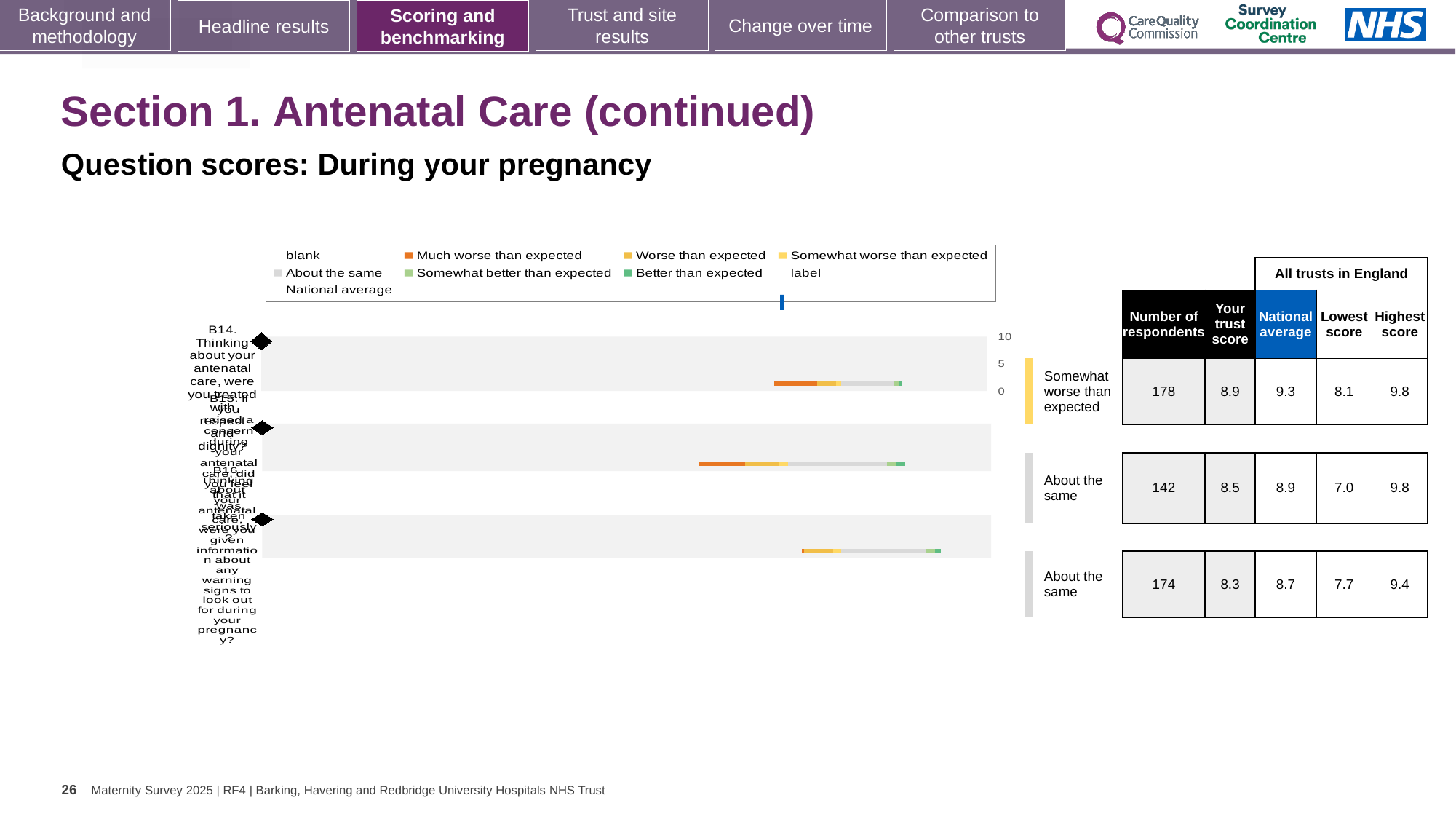
In the table beside the chart, what is the difference between the national average and the trust score for the top row? 0.4 Which legend entry is shown in orange in the chart? Much worse than expected In the table beside the chart, is the trust score for the second row (8.5) larger or smaller than the trust score for the third row (8.3)? larger In the table beside the chart, what is the number of respondents for the top row (Somewhat worse than expected)? 178 What is the label of the first (top) bar in the chart? B14. Thinking about your antenatal care, were you treated with respect and dignity? In the table beside the chart, what is the highest score for the third (bottom) row? 9.4 In the table beside the chart, what is the national average for the top row? 9.3 In the table beside the chart, which row has the highest number of respondents? the top row (178) What kind of chart is shown on the slide? bar chart In the table beside the chart, what is the trust score for the top row (Somewhat worse than expected)? 8.9 In the table beside the chart, what is the lowest score for the second row? 7.0 How many bars (questions) are plotted in the chart? 3